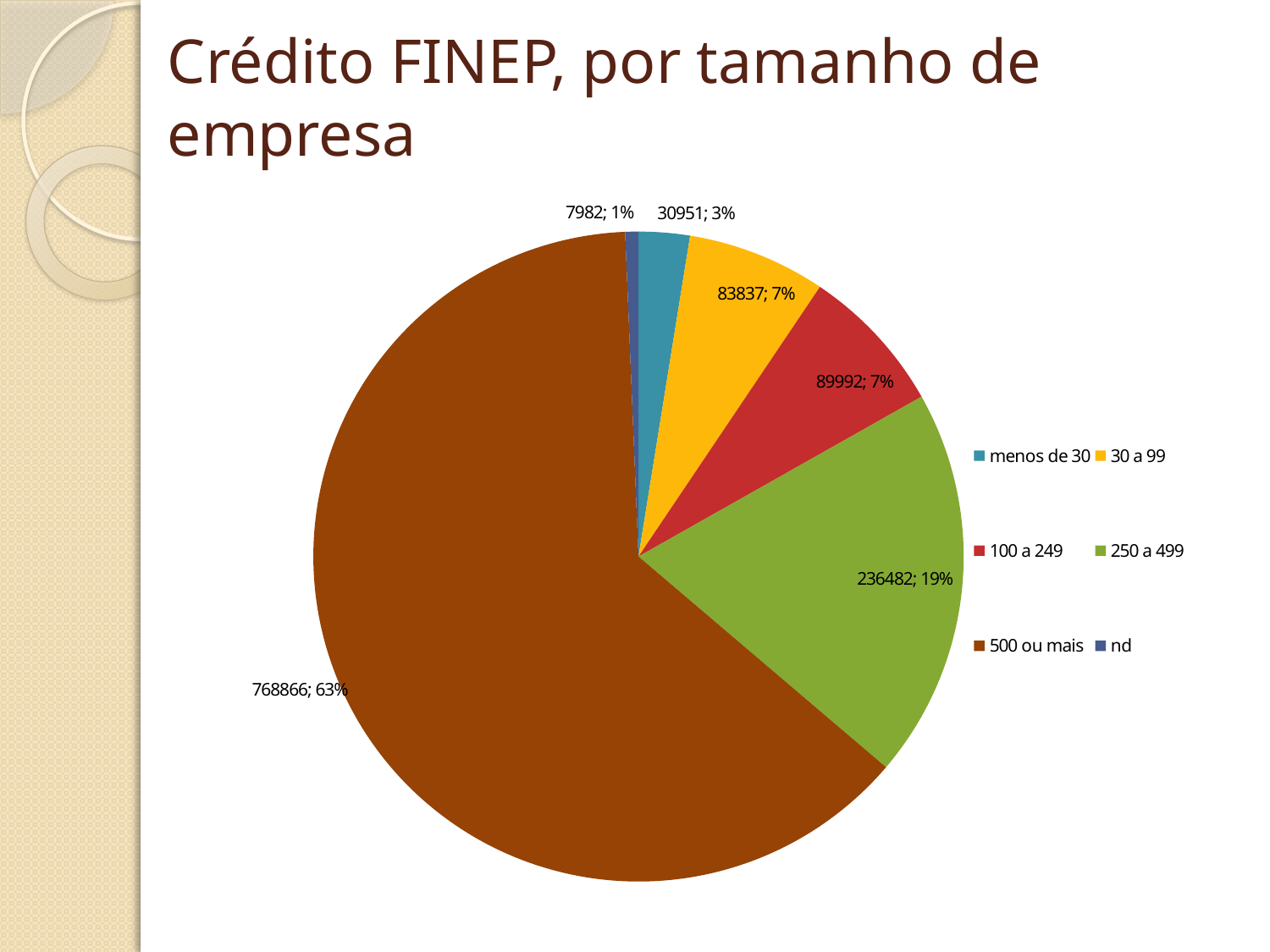
What share of the pie does the '500 ou mais' slice represent? 63% What is the difference between the values for '500 ou mais' and '250 a 499'? 532384 Which category has the smallest slice of the pie? nd What is the title of the chart on the slide? Crédito FINEP, por tamanho de empresa What value is shown for the '250 a 499' slice? 236482 Which category has the largest slice of the pie? 500 ou mais How many slices does the pie chart have? 6 What share of the pie does the '250 a 499' slice represent? 19% What value is shown for the 'nd' slice? 7982 What kind of chart is shown on the slide? pie chart What value is shown for the 'menos de 30' slice? 30951 What value is shown for the '500 ou mais' slice? 768866